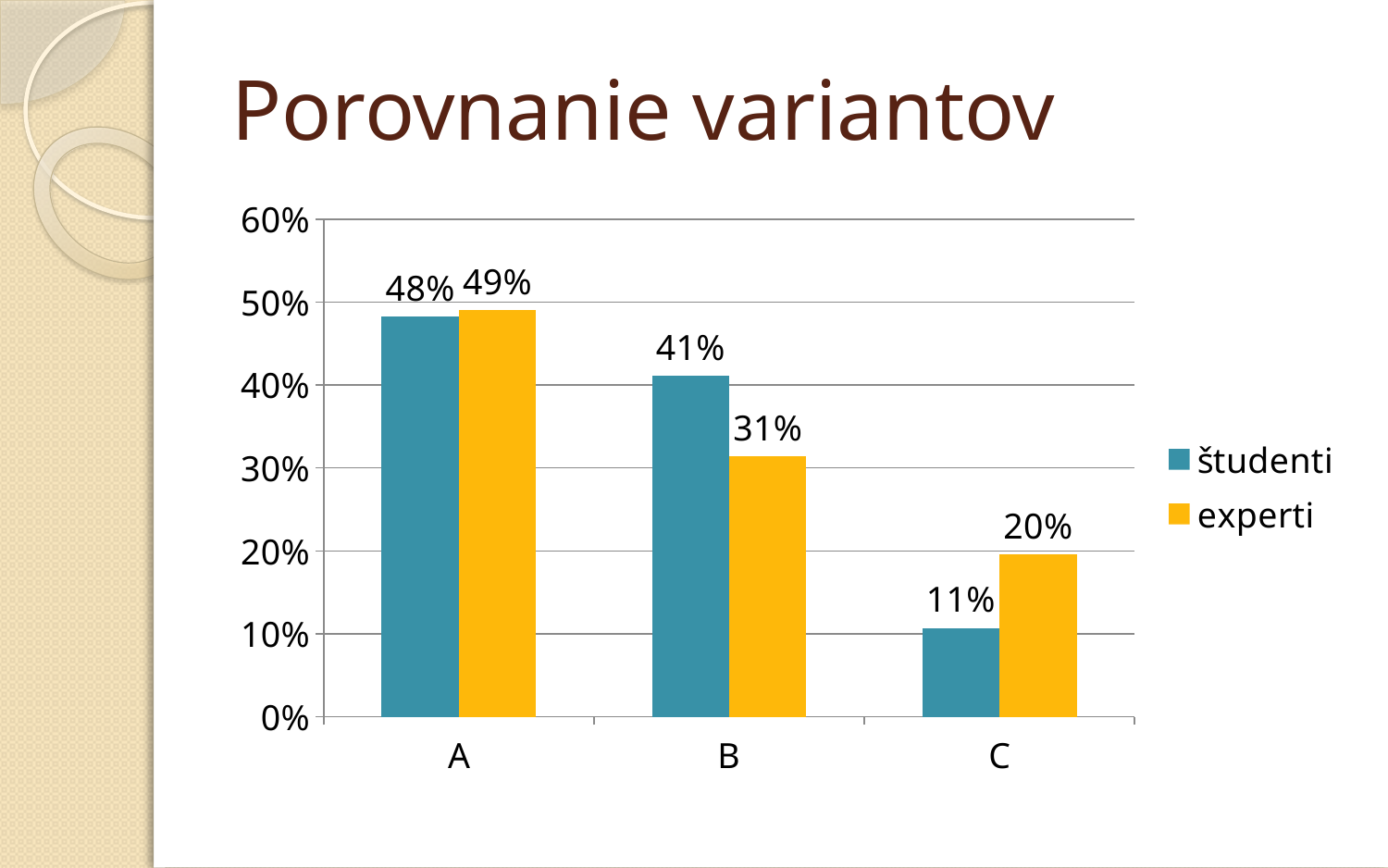
Is the value for študenti in category B greater or less than 30%? greater How many series does the legend list? 2 In category C, which series has the larger value, študenti or experti? experti What kind of chart is shown on the slide? bar chart What is the value for študenti in category A? 48% Which category has the lowest value for študenti? C What is the difference between študenti and experti in category B? 10% What is the value for experti in category B? 31% How many categories are shown on the x axis? 3 Which category has the highest value for experti? A Do the values for experti rise or fall from category A to category C? fall What is the value for experti in category C? 20%